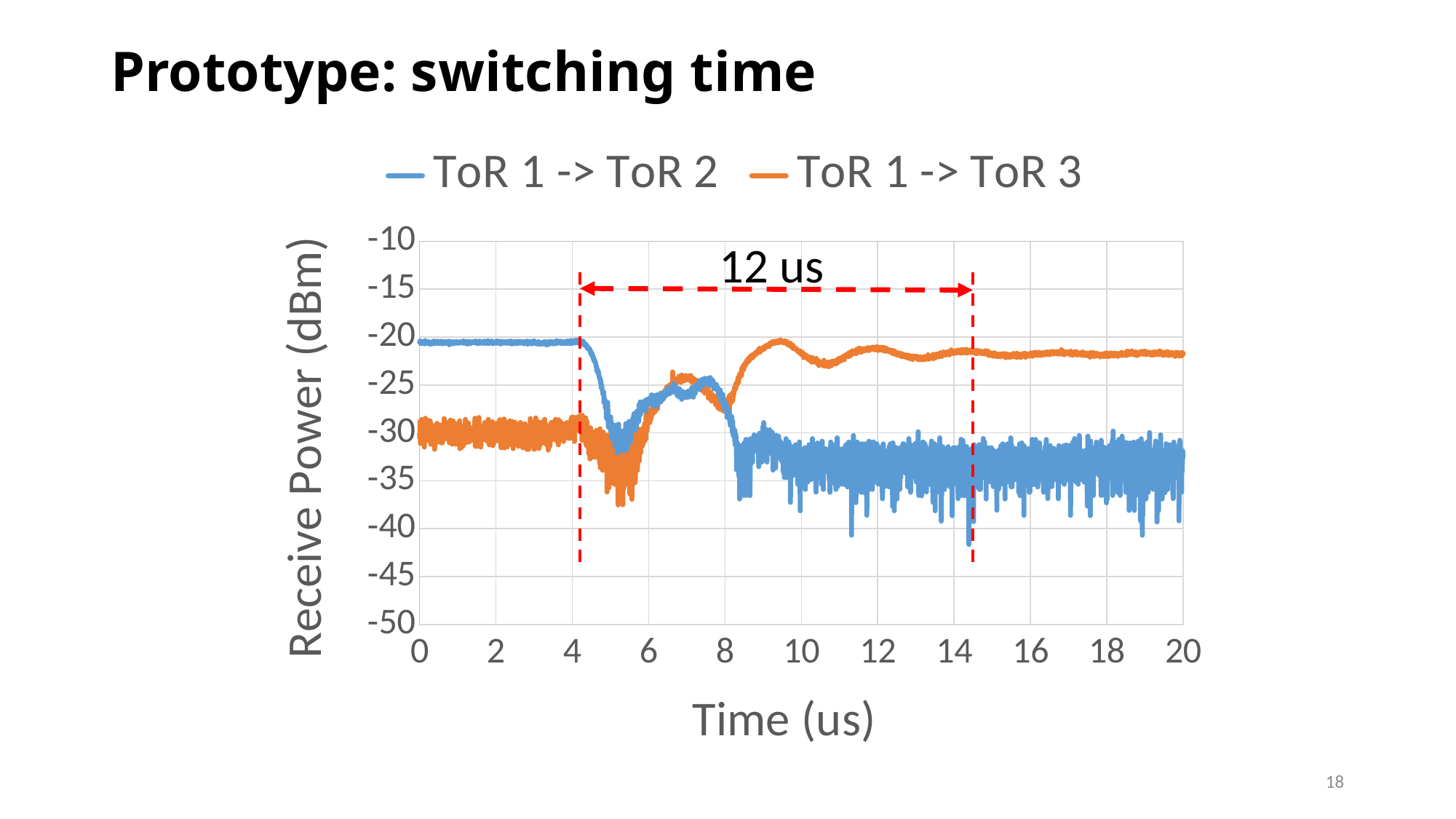
What are the two series named in the legend? ToR 1 -> ToR 2 and ToR 1 -> ToR 3 What duration is marked by the red dashed arrow annotation on the chart? 12 us Overall, does the ToR 1 -> ToR 2 series rise or fall from time 0 to time 20 us? fall Is the value for ToR 1 -> ToR 2 at time 2 us greater or less than -25 dBm? greater Is the value for ToR 1 -> ToR 3 at time 18 us greater or less than -25 dBm? greater How many series does the legend list? 2 Is the value for ToR 1 -> ToR 3 at time 2 us greater or less than -25 dBm? less At time 2 us, which series has the higher receive power, ToR 1 -> ToR 2 or ToR 1 -> ToR 3? ToR 1 -> ToR 2 What kind of chart is shown on the slide? Line chart At time 18 us, which series has the higher receive power, ToR 1 -> ToR 2 or ToR 1 -> ToR 3? ToR 1 -> ToR 3 What is the label of the y axis? Receive Power (dBm)